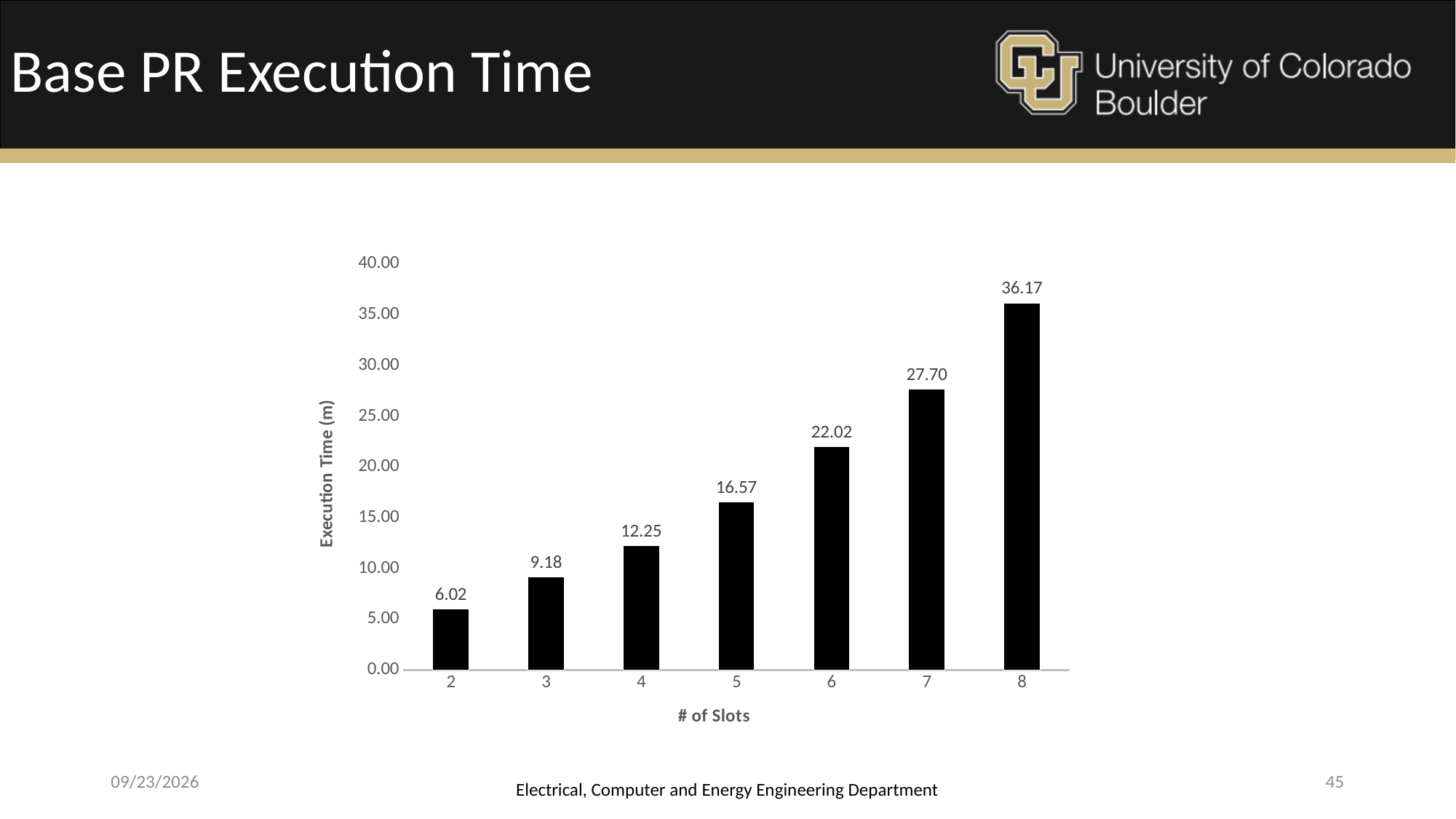
Which number of slots has the highest execution time? 8 Which number of slots has the lowest execution time? 2 What is the difference in execution time between 8 slots and 7 slots? 8.47 What kind of chart is shown on the slide? Bar chart Does execution time rise or fall as the number of slots increases? Rises What is the execution time for 7 slots? 27.70 What is the execution time for 5 slots? 16.57 What is the execution time for 2 slots? 6.02 Is the execution time for 6 slots greater or less than 20.00? greater Which has a larger execution time, 6 slots or 4 slots? 6 slots What is the difference in execution time between 4 slots and 3 slots? 3.07 How many slot counts are shown on the x axis? 7